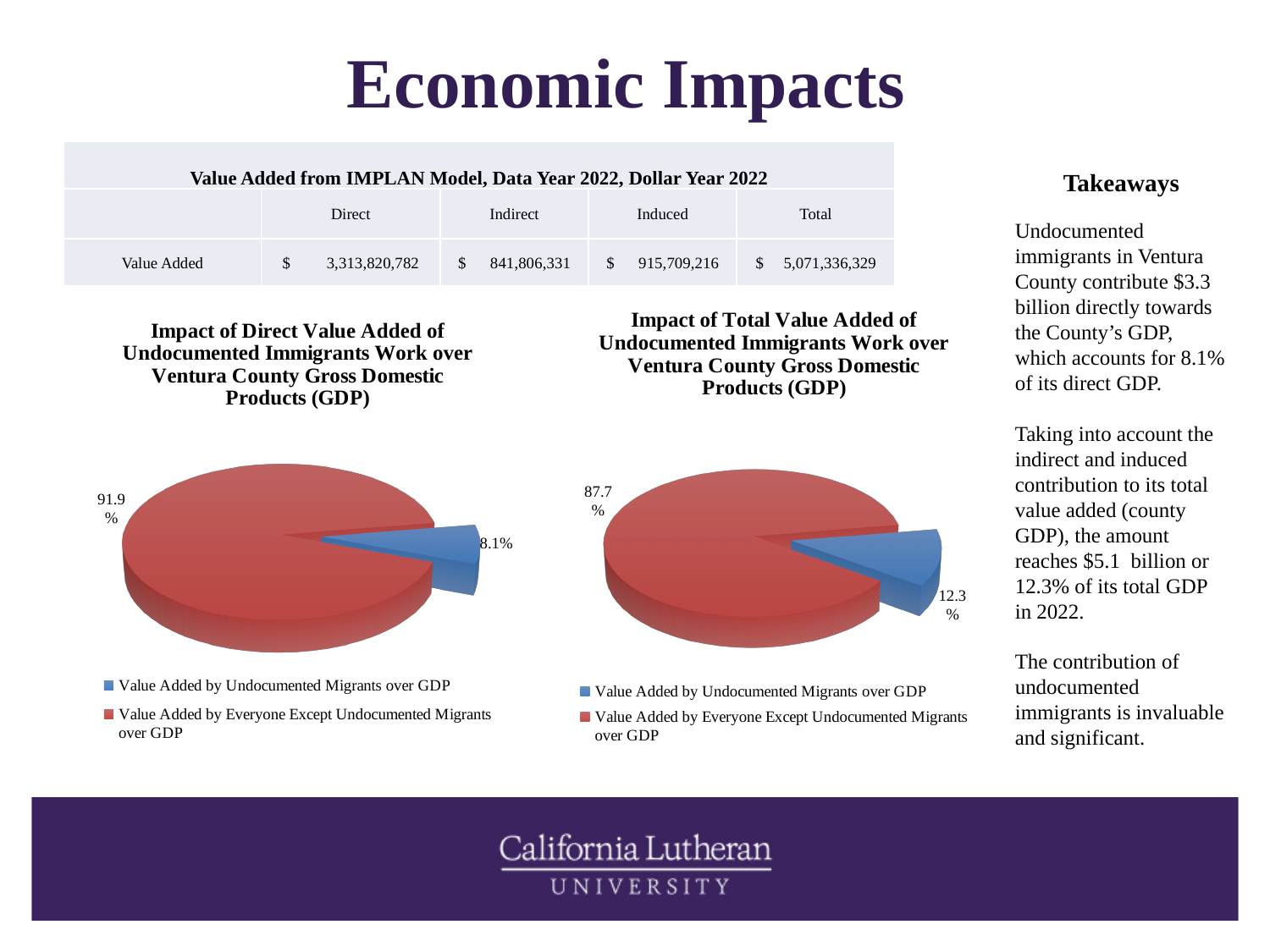
In the 'Impact of Direct Value Added' chart, what share of GDP is Value Added by Everyone Except Undocumented Migrants? 91.9% What kind of chart is the 'Impact of Direct Value Added' chart? Pie chart In the 'Impact of Direct Value Added' chart, which slice is the largest? Value Added by Everyone Except Undocumented Migrants over GDP In the 'Impact of Total Value Added' chart, which slice is the smallest? Value Added by Undocumented Migrants over GDP What kind of chart is the 'Impact of Total Value Added' chart? Pie chart How many entries does the legend of the 'Impact of Direct Value Added' chart list? 2 In the 'Impact of Direct Value Added' chart, what share of GDP is Value Added by Undocumented Migrants? 8.1% Which is larger: the undocumented migrants' share in the 'Impact of Direct Value Added' chart or in the 'Impact of Total Value Added' chart? Impact of Total Value Added (12.3%) In the 'Impact of Direct Value Added' chart, what is the difference between the two slices' shares? 83.8% How many slices does the 'Impact of Total Value Added' pie chart have? 2 In the 'Impact of Total Value Added' chart, what share of GDP is Value Added by Undocumented Migrants? 12.3% In the 'Impact of Total Value Added' chart, what share of GDP is Value Added by Everyone Except Undocumented Migrants? 87.7%